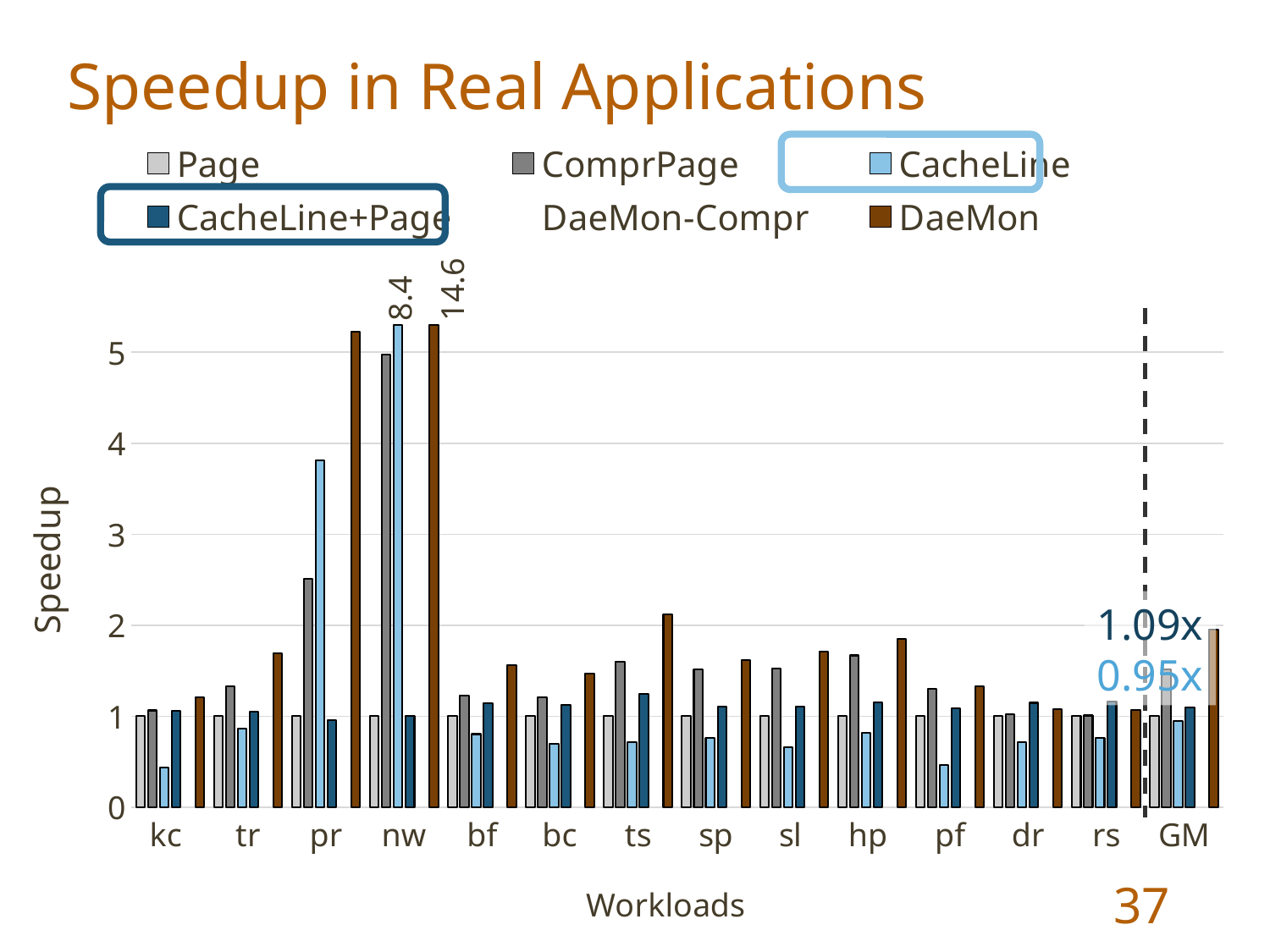
What is the DaeMon speedup for the nw workload? 14.6 What is the label of the y axis? Speedup Is the DaeMon speedup for the pr workload greater or less than 5? greater For the pr workload, which is larger: the CacheLine speedup or the ComprPage speedup? CacheLine How many series does the legend list? 6 What is the CacheLine speedup for the nw workload? 8.4 Is the CacheLine speedup for the kc workload greater or less than 1? less What is the title of the chart? Speedup in Real Applications What is the difference between the DaeMon and CacheLine speedups for the nw workload? 6.2 What type of chart is shown on the slide? Bar chart Which workload has the highest DaeMon speedup? nw How many workloads are shown on the x axis? 14